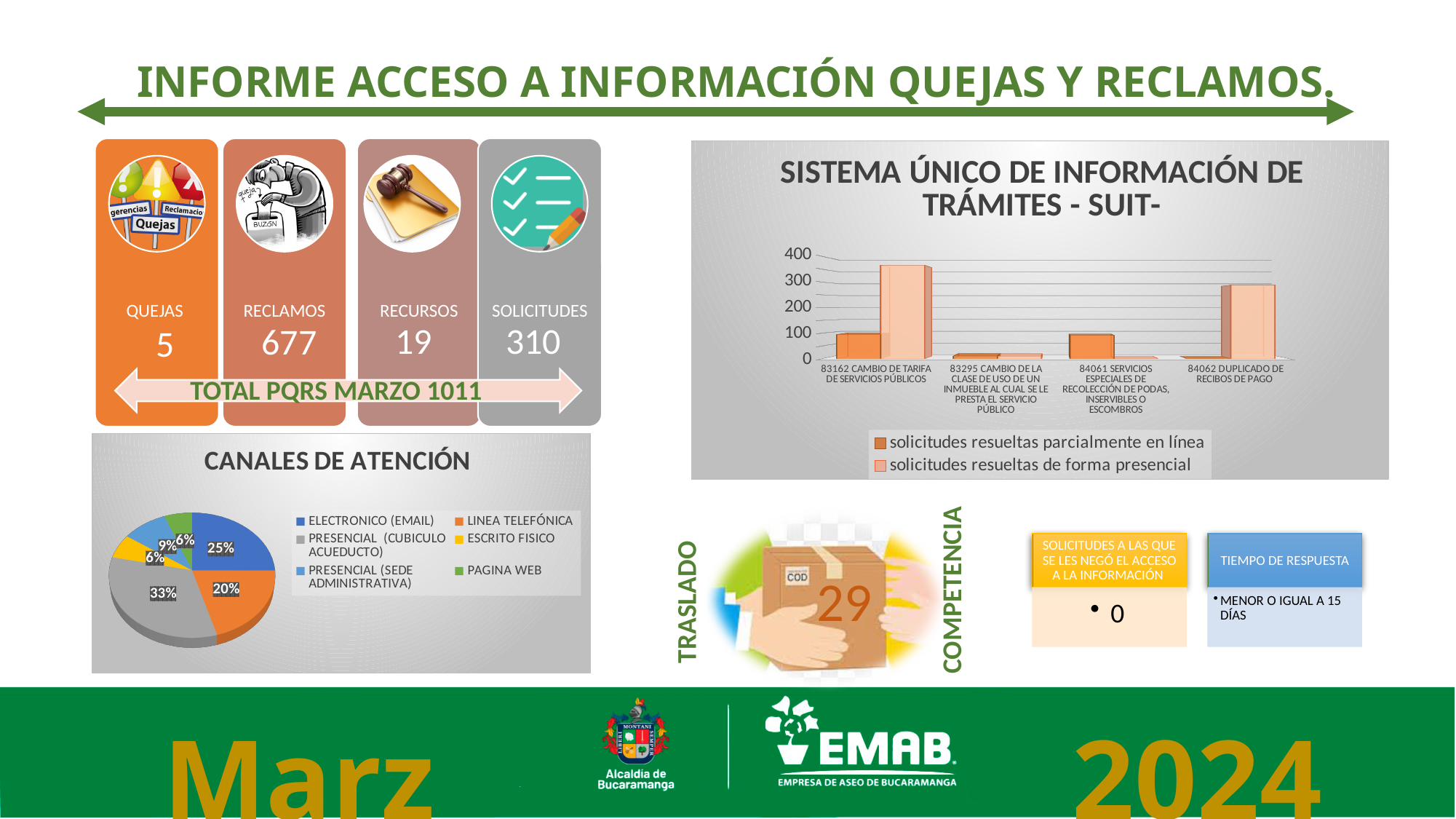
In the CANALES DE ATENCIÓN chart, how many channels does the legend list? 6 In the CANALES DE ATENCIÓN chart, what share does LINEA TELEFÓNICA have? 20% How many categories are shown on the x axis of the SISTEMA ÚNICO DE INFORMACIÓN DE TRÁMITES - SUIT- chart? 4 What kind of chart is the SISTEMA ÚNICO DE INFORMACIÓN DE TRÁMITES - SUIT- chart? bar chart How many series does the legend of the SISTEMA ÚNICO DE INFORMACIÓN DE TRÁMITES - SUIT- chart list? 2 What kind of chart is the CANALES DE ATENCIÓN chart? pie chart In the SISTEMA ÚNICO DE INFORMACIÓN DE TRÁMITES - SUIT- chart, which category has the highest value for solicitudes resueltas de forma presencial? 83162 CAMBIO DE TARIFA DE SERVICIOS PÚBLICOS In the SISTEMA ÚNICO DE INFORMACIÓN DE TRÁMITES - SUIT- chart, is the value of solicitudes resueltas de forma presencial for 83162 CAMBIO DE TARIFA DE SERVICIOS PÚBLICOS greater or less than 300? greater In the CANALES DE ATENCIÓN chart, which channel has the largest share? PRESENCIAL (CUBICULO ACUEDUCTO) In the CANALES DE ATENCIÓN chart, what share does ELECTRONICO (EMAIL) have? 25% In the CANALES DE ATENCIÓN chart, what is the difference between the shares of PRESENCIAL (CUBICULO ACUEDUCTO) and ELECTRONICO (EMAIL)? 8% In the CANALES DE ATENCIÓN chart, what share does PRESENCIAL (CUBICULO ACUEDUCTO) have? 33%